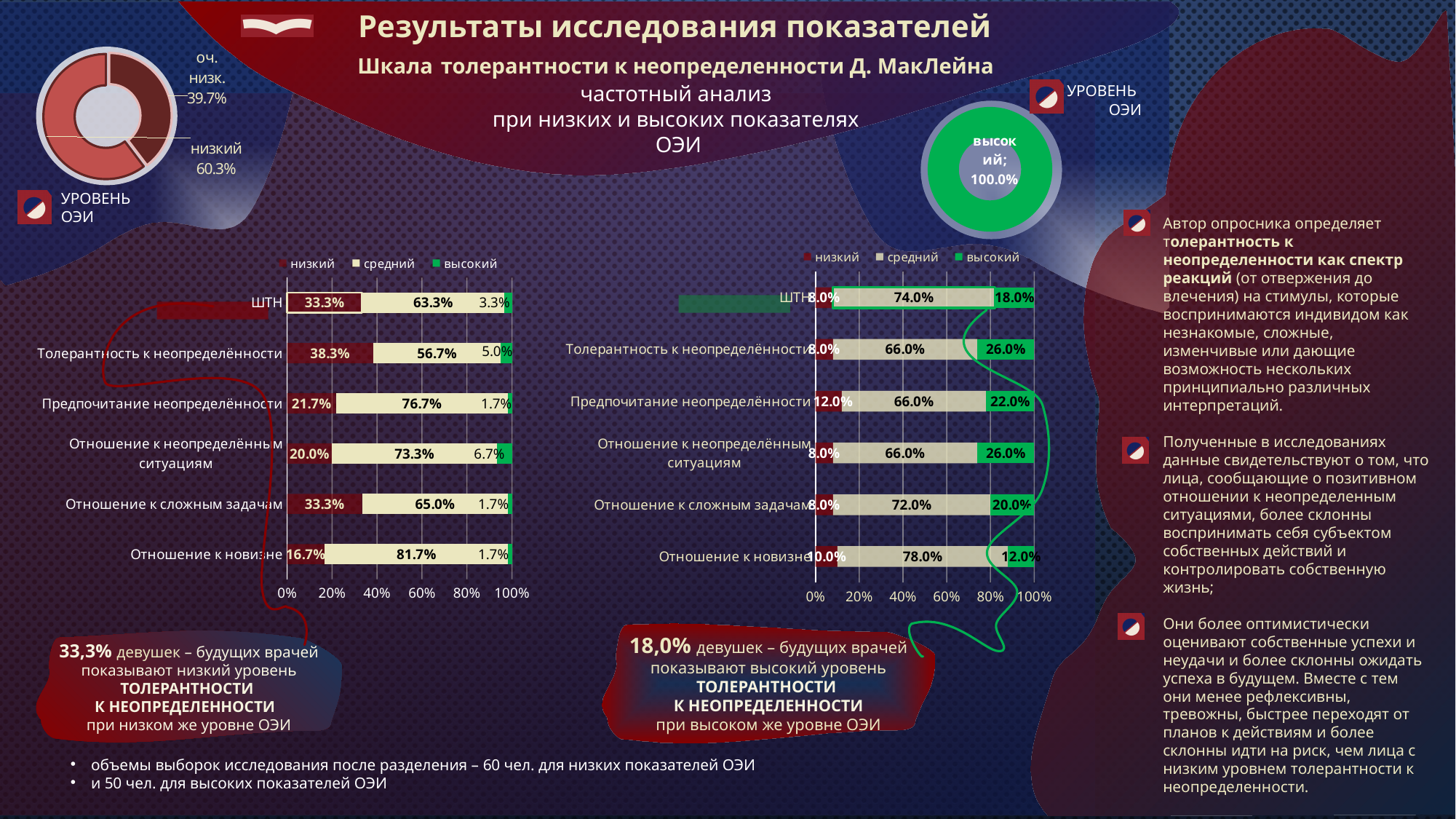
In the top-left doughnut chart (УРОВЕНЬ ОЭИ), what share is labelled 'оч. низк.'? 39.7% How many series does the legend of the left stacked bar chart list? 3 In the left stacked bar chart, which category has the lowest 'низкий' value? Отношение к новизне In the right stacked bar chart, what is the difference between the 'высокий' values for 'Толерантность к неопределённости' and 'Отношение к новизне'? 14.0% In the left stacked bar chart, what is the 'низкий' value for 'Толерантность к неопределённости'? 38.3% In the right stacked bar chart, what is the 'высокий' value for 'ШТН'? 18.0% In the right stacked bar chart, which category has the highest 'средний' value? Отношение к новизне In the top-left doughnut chart (УРОВЕНЬ ОЭИ), what share is labelled 'низкий'? 60.3% In the left stacked bar chart, which category has the highest 'средний' value? Отношение к новизне In the top-right doughnut chart, what value is shown for 'высокий'? 100.0% What type of chart is the chart in the top-left corner of the slide? Doughnut chart In the left stacked bar chart, what is the 'средний' value for 'Отношение к новизне'? 81.7%